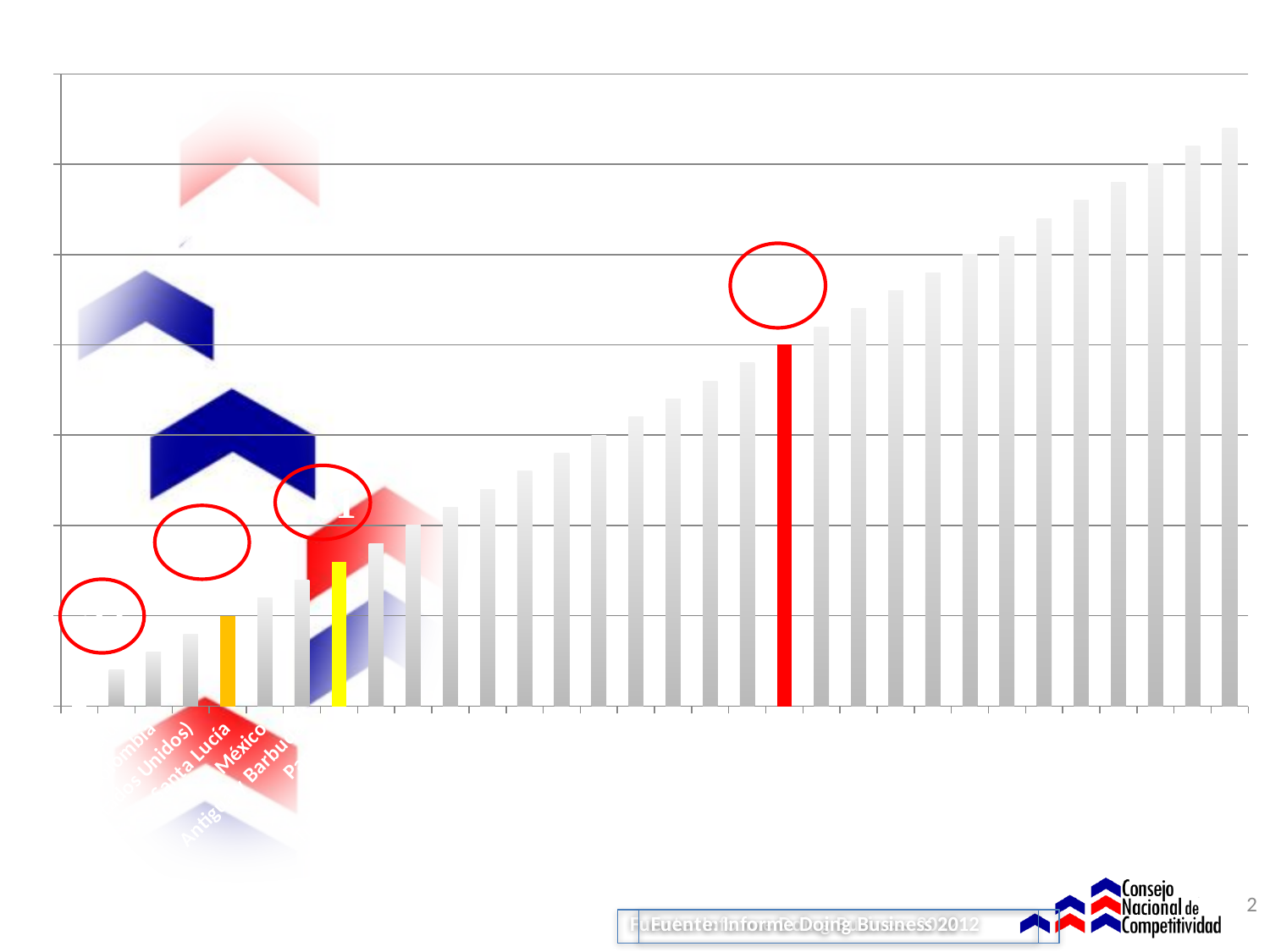
How many bars are highlighted in a colour other than grey? 3 Which is taller, the red highlighted bar or the yellow highlighted bar? the red bar What colour is the tallest of the highlighted (non-grey) bars? red Do the bar values rise or fall from left to right along the x axis? rise What kind of chart is shown on the slide? bar chart Which is taller, the yellow highlighted bar or the orange highlighted bar? the yellow bar How many bars are plotted in the chart? 32